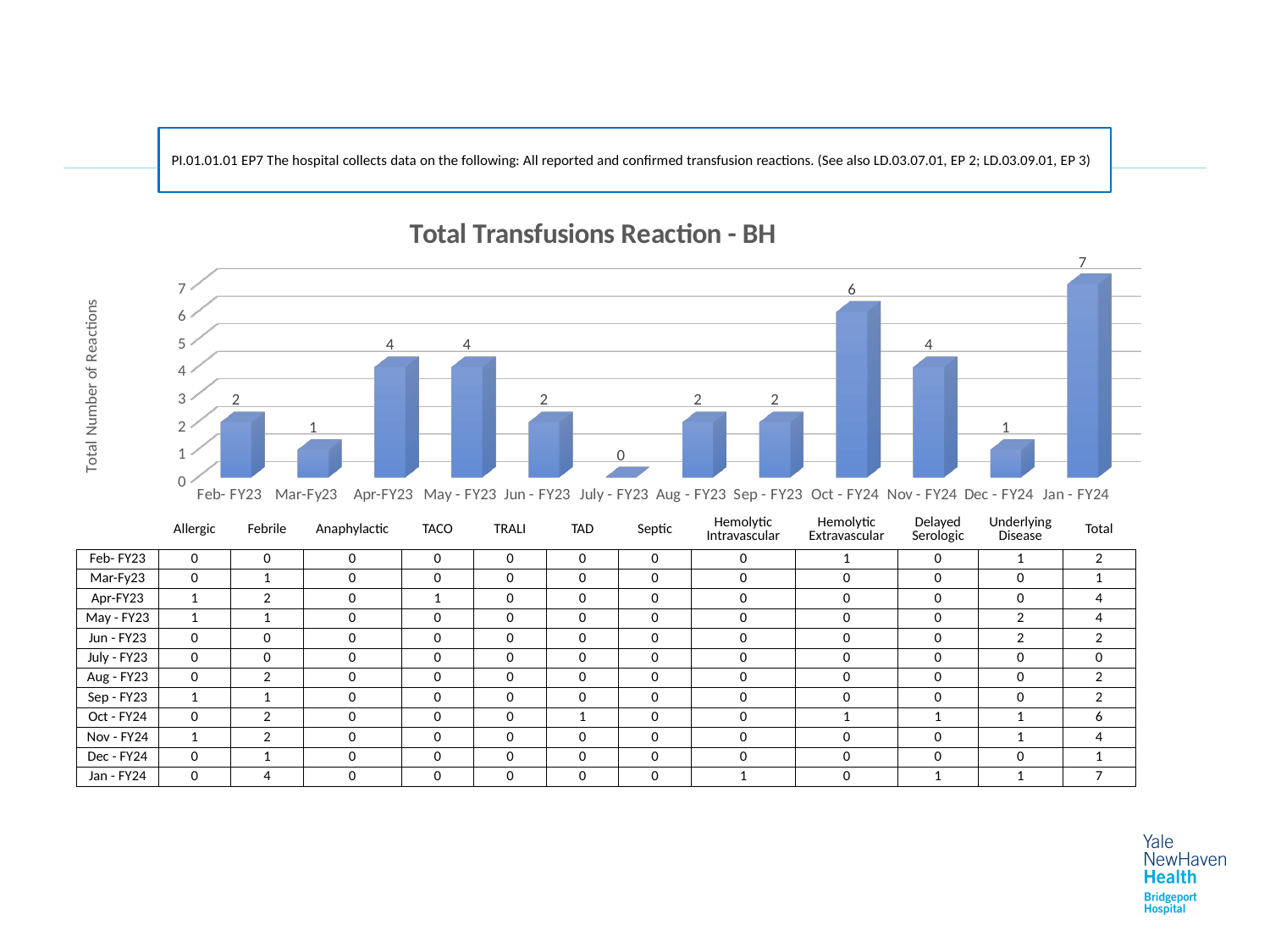
What is the total number of reactions for Jan - FY24? 7 What is the difference between the total reactions in Jan - FY24 and Oct - FY24? 1 What is the total number of reactions for Oct - FY24? 6 Which month has more reactions, Apr-FY23 or Feb- FY23? Apr-FY23 What is the title of the chart? Total Transfusions Reaction - BH What is the label of the vertical axis? Total Number of Reactions Is the value for Nov - FY24 greater or less than 3? greater Which month has the lowest total number of reactions? July - FY23 What kind of chart is shown on the slide? Bar chart How many months are shown on the x axis of the chart? 12 Which month has the highest total number of reactions? Jan - FY24 What is the total number of reactions for Mar-Fy23? 1